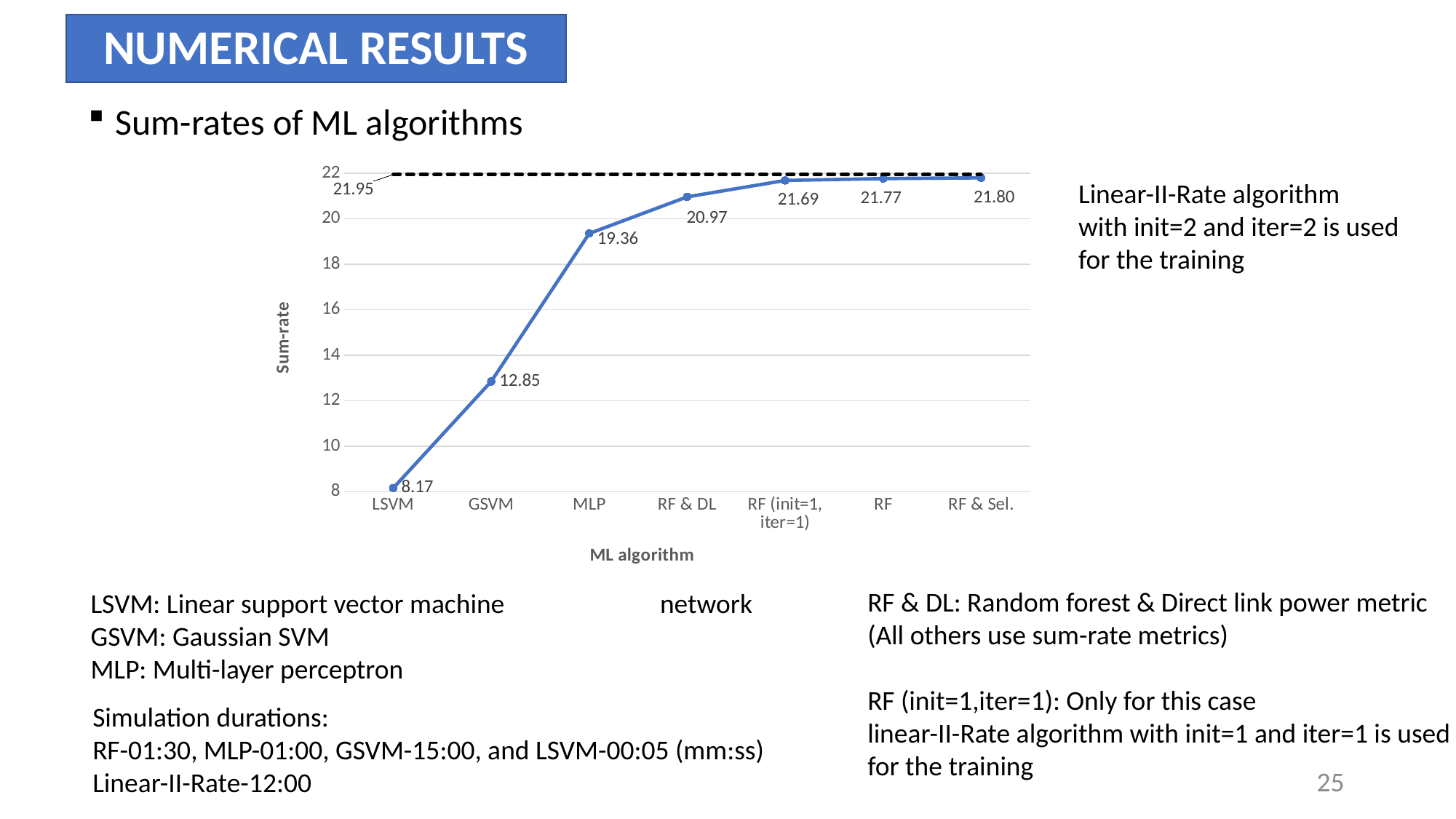
Which ML algorithm has the highest plotted sum-rate? RF & Sel. What is the difference between the sum-rate of MLP and the sum-rate of GSVM? 6.51 Which has a larger sum-rate, RF & DL or MLP? RF & DL Which ML algorithm has the lowest sum-rate? LSVM Do the sum-rate values rise or fall from LSVM to RF & Sel. along the x axis? Rise How many ML algorithms are plotted on the x axis? 7 What is the sum-rate value for GSVM? 12.85 What is the sum-rate value for RF & Sel.? 21.80 What kind of chart is shown on the slide? Line chart What is the sum-rate value for RF & DL? 20.97 What is the sum-rate value for MLP? 19.36 What is the difference between the dashed reference line value and the sum-rate of RF & Sel.? 0.15